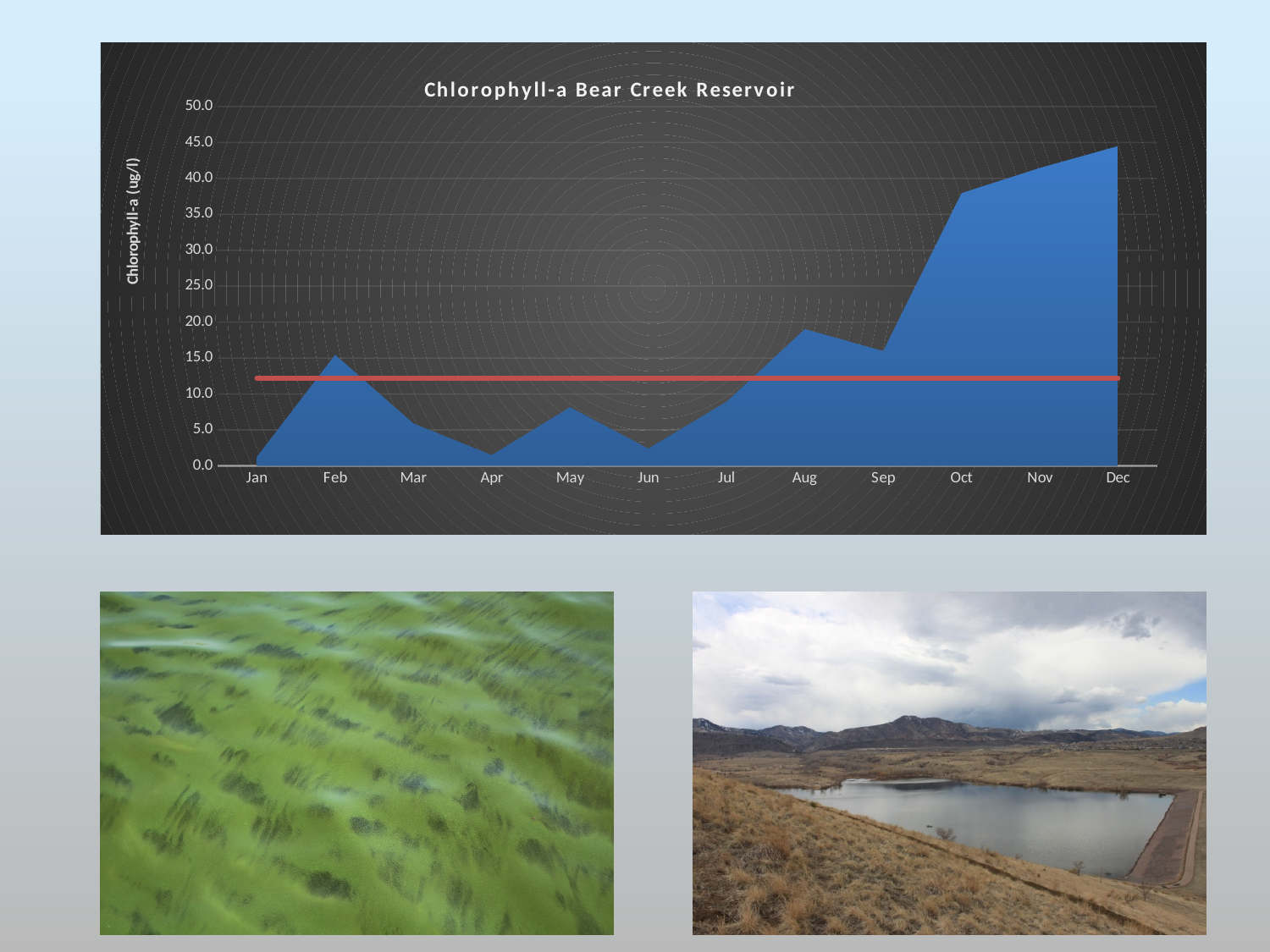
Is the value for Oct greater or less than 35.0? greater How many months are plotted along the x axis of the chart? 12 Overall, do the chlorophyll-a values rise or fall from Jan to Dec? rise What kind of chart is shown on the slide? Combination area and line chart Is the value for Aug greater or less than 15.0? greater Is the value for Dec greater or less than 40.0? greater Which month has the highest chlorophyll-a value? Dec What is the label on the vertical axis of the chart? Chlorophyll-a (ug/l) What is the title of the chart? Chlorophyll-a Bear Creek Reservoir Which month has the larger chlorophyll-a value, Feb or Mar? Feb